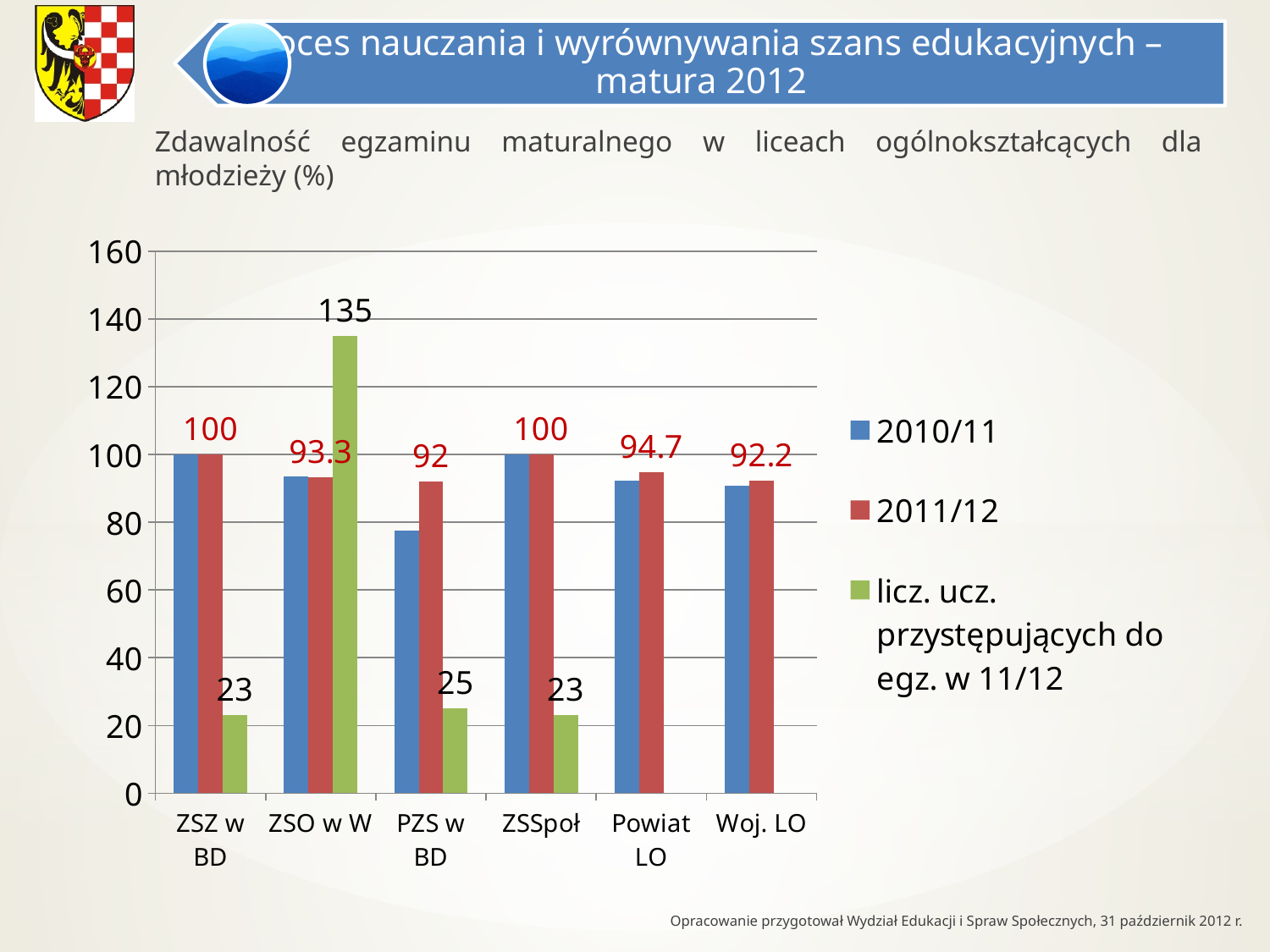
How many categories are shown on the x axis? 6 Which category has the highest value for 'licz. ucz. przystępujących do egz. w 11/12'? ZSO w W Is the 2010/11 value for Woj. LO greater or less than 80? greater Is the 2010/11 value for PZS w BD greater or less than 80? less What is the value of 'licz. ucz. przystępujących do egz. w 11/12' for ZSO w W? 135 What is the 2011/12 value for PZS w BD? 92 What is the 2011/12 value for Powiat LO? 94.7 What is the difference between the 'licz. ucz. przystępujących do egz. w 11/12' values for ZSO w W and PZS w BD? 110 What kind of chart is shown on the slide? bar chart How many series does the legend list? 3 Which has the larger 2011/12 value, ZSO w W or Powiat LO? Powiat LO What is the difference between the 2011/12 values for Powiat LO and Woj. LO? 2.5